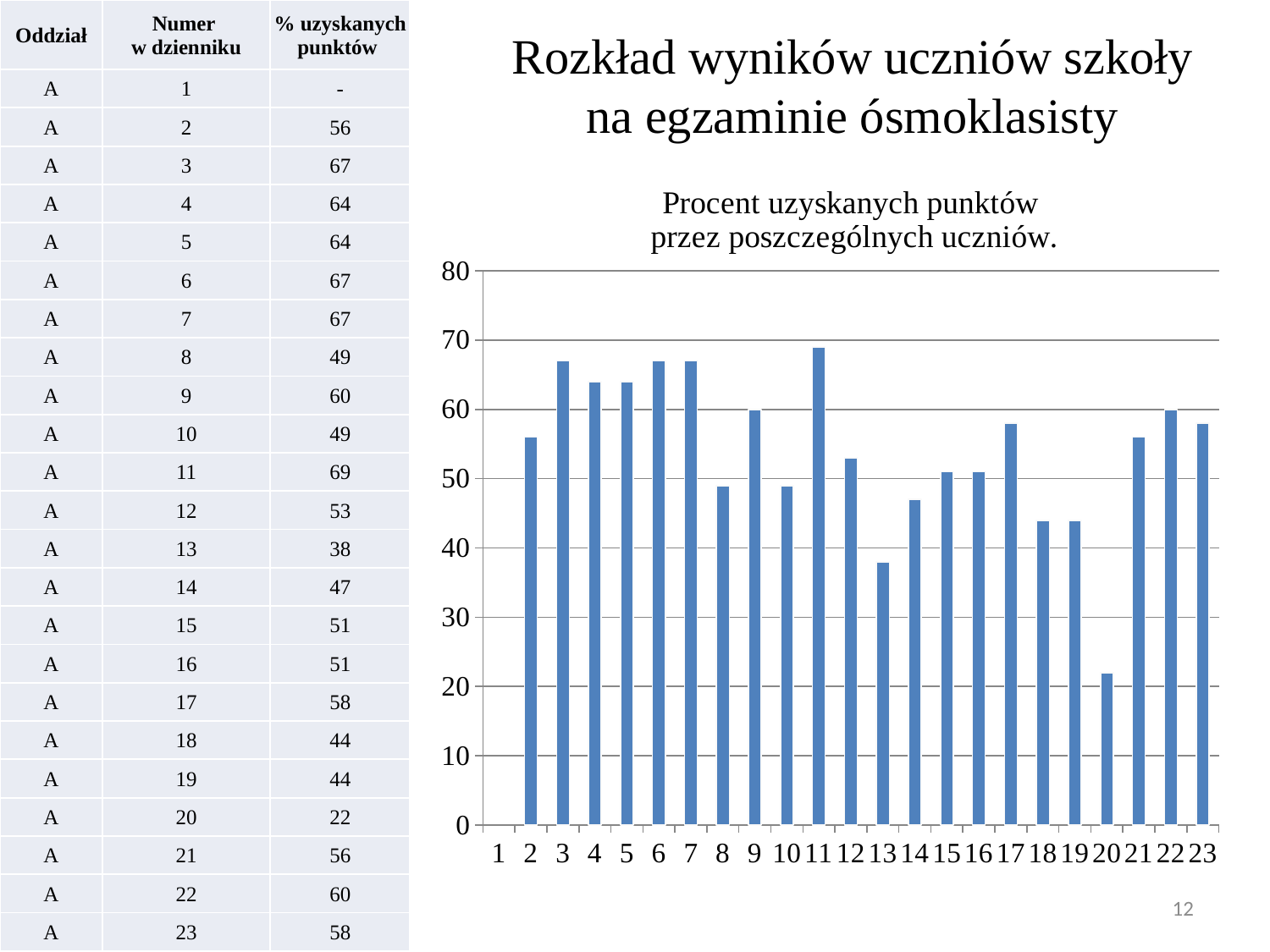
Which bar is taller, student 17 or student 18? student 17 Which bar is taller, student 3 or student 8? student 3 Is the value for student 11 greater or less than 60? greater What is the subtitle printed above the chart? Procent uzyskanych punktów przez poszczególnych uczniów. Is the value for student 13 greater or less than 40? less According to the table on the slide, what percentage of points did student 11 obtain? 69 According to the table on the slide, what percentage of points did student 20 obtain? 22 Which student number has the lowest bar in the chart? 20 Which student number has the highest bar in the chart? 11 Is the value for student 20 greater or less than 30? less What kind of chart is shown on the slide? bar chart How many student numbers are listed along the x axis of the chart? 23